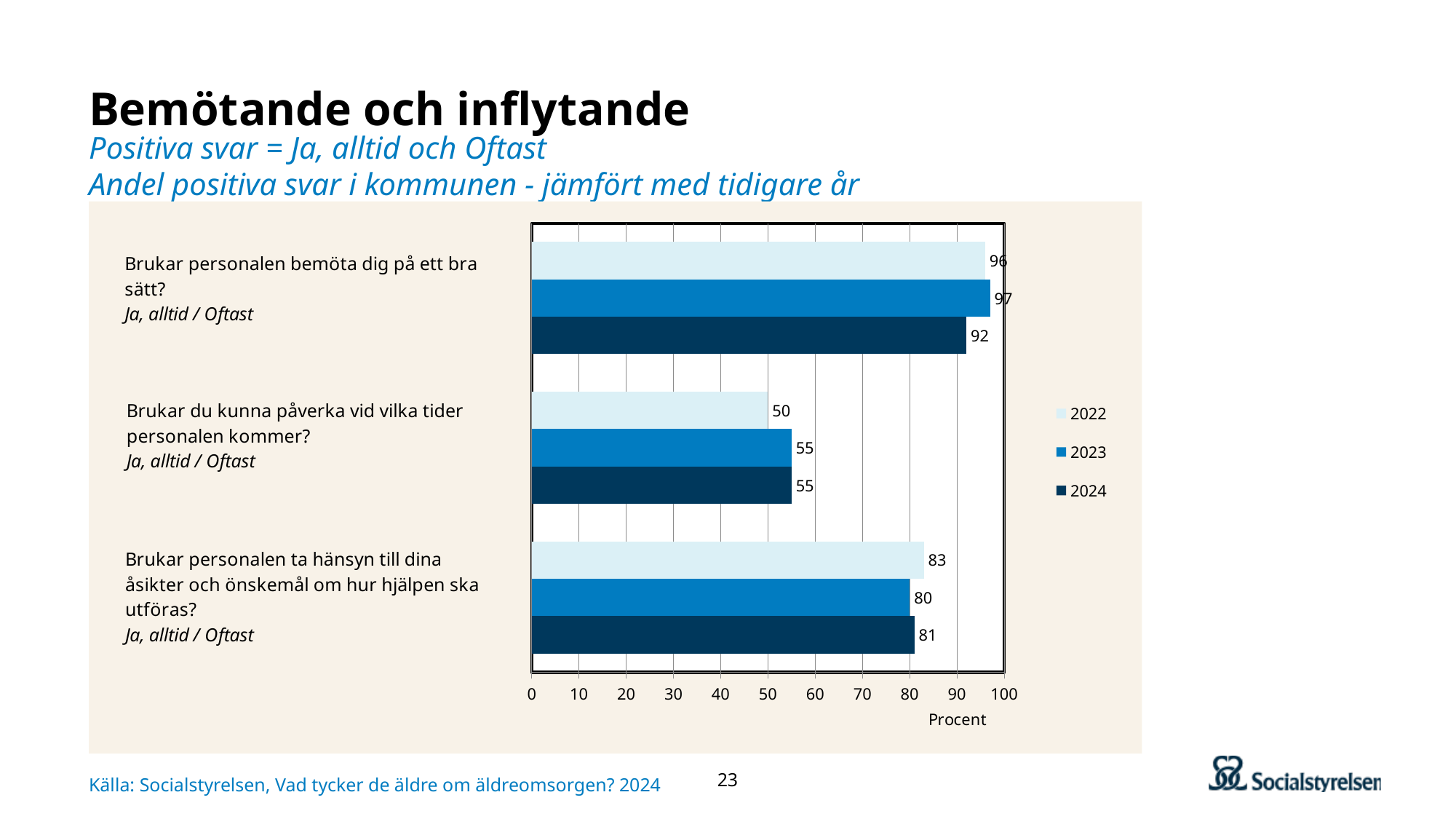
How many question categories are plotted in the chart? 3 Which year has the highest value for "Brukar personalen bemöta dig på ett bra sätt?" 2023 What is the 2024 value for "Brukar personalen bemöta dig på ett bra sätt?" 92 What is the 2023 value for "Brukar personalen ta hänsyn till dina åsikter och önskemål om hur hjälpen ska utföras?" 80 What is the 2022 value for "Brukar du kunna påverka vid vilka tider personalen kommer?" 50 What is the difference between the 2022 and 2023 values for "Brukar du kunna påverka vid vilka tider personalen kommer?" 5 What kind of chart is shown on the slide? Bar chart What is the difference between the 2023 and 2024 values for "Brukar personalen bemöta dig på ett bra sätt?" 5 Which is larger for "Brukar personalen ta hänsyn till dina åsikter och önskemål om hur hjälpen ska utföras?": the 2022 value or the 2024 value? 2022 Which question has the lowest 2024 value? Brukar du kunna påverka vid vilka tider personalen kommer? How many series does the legend list? 3 What unit is labelled on the x axis of the chart? Procent